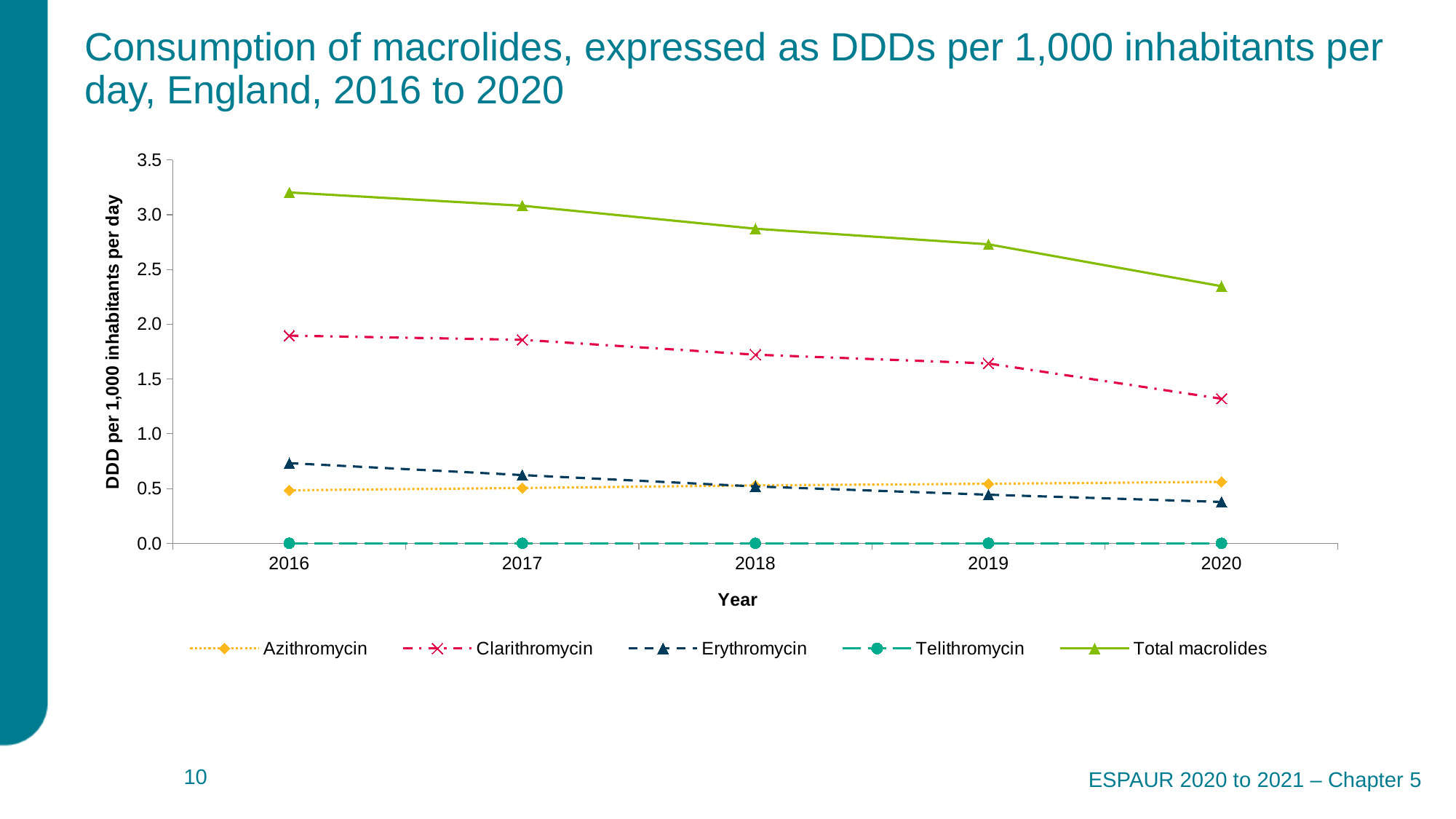
Which is larger in 2018, Clarithromycin or Erythromycin? Clarithromycin Is the value for Clarithromycin in 2020 greater or less than 1.5? less Does the Total macrolides line rise or fall from 2016 to 2020? fall Does the Clarithromycin line rise or fall from 2016 to 2020? fall Is the value for Total macrolides in 2016 greater or less than 3.0? greater How many series does the legend list? 5 Is the value for Erythromycin in 2016 greater or less than 0.5? greater How many years are plotted along the x axis? 5 What kind of chart is shown on the slide? line chart Which series has the lowest values across all years? Telithromycin Which series has the highest value in 2016? Total macrolides